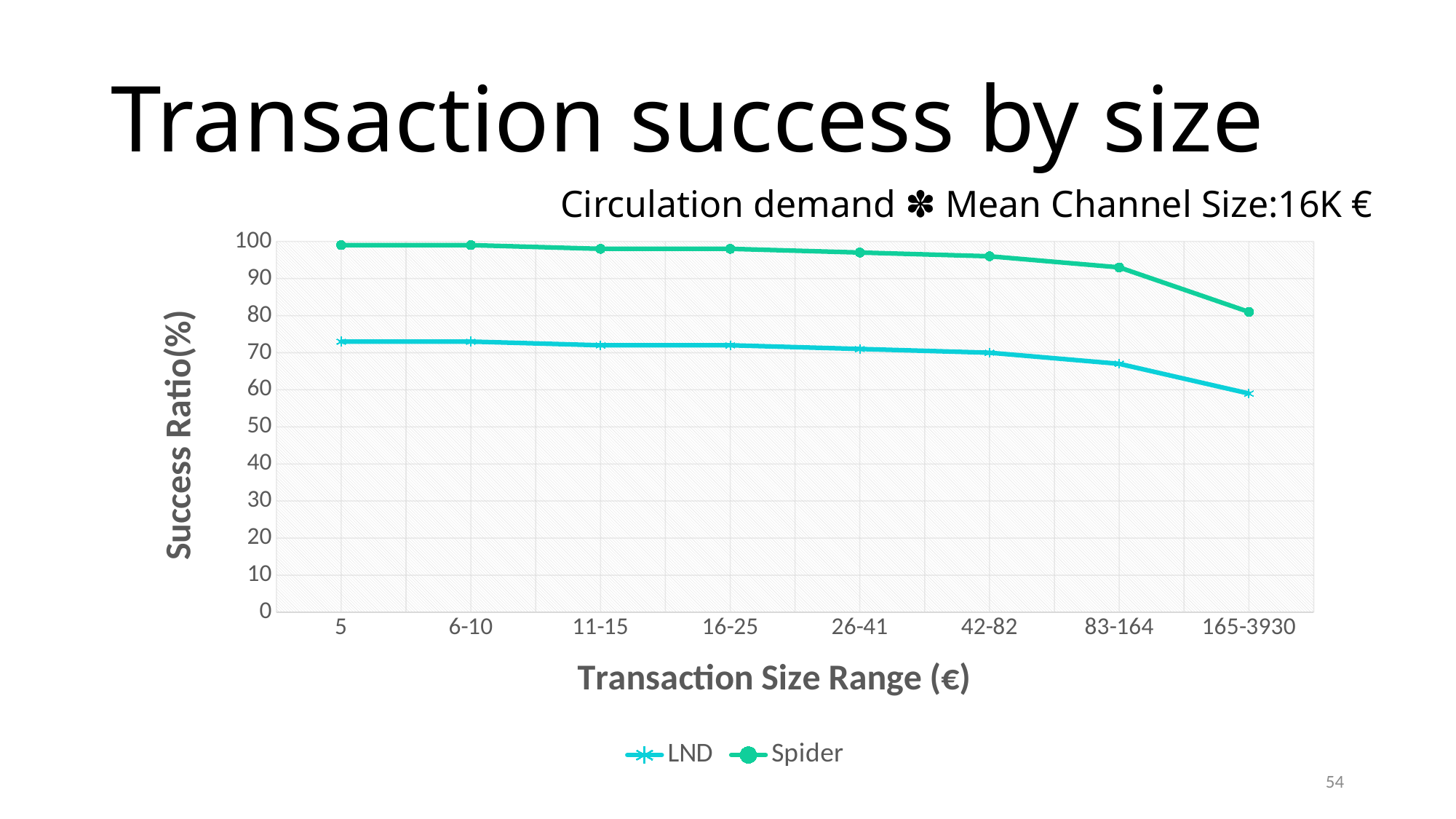
For which transaction size range is the Spider success ratio lowest? 165-3930 For which transaction size range is the LND success ratio lowest? 165-3930 How many series does the legend list? 2 Which series are listed in the legend? LND and Spider Do the success ratios for Spider rise or fall as the transaction size range increases along the x axis? fall Is the LND success ratio for the 5 range greater or less than 70? greater Is the Spider success ratio for the 83-164 range greater or less than 90? greater Which series has the higher success ratio at the 16-25 transaction size range, LND or Spider? Spider How many transaction size ranges are shown on the x axis? 8 What kind of chart is shown on the slide? line chart What is the label of the y axis? Success Ratio(%) Is the LND success ratio for the 165-3930 range greater or less than 70? less